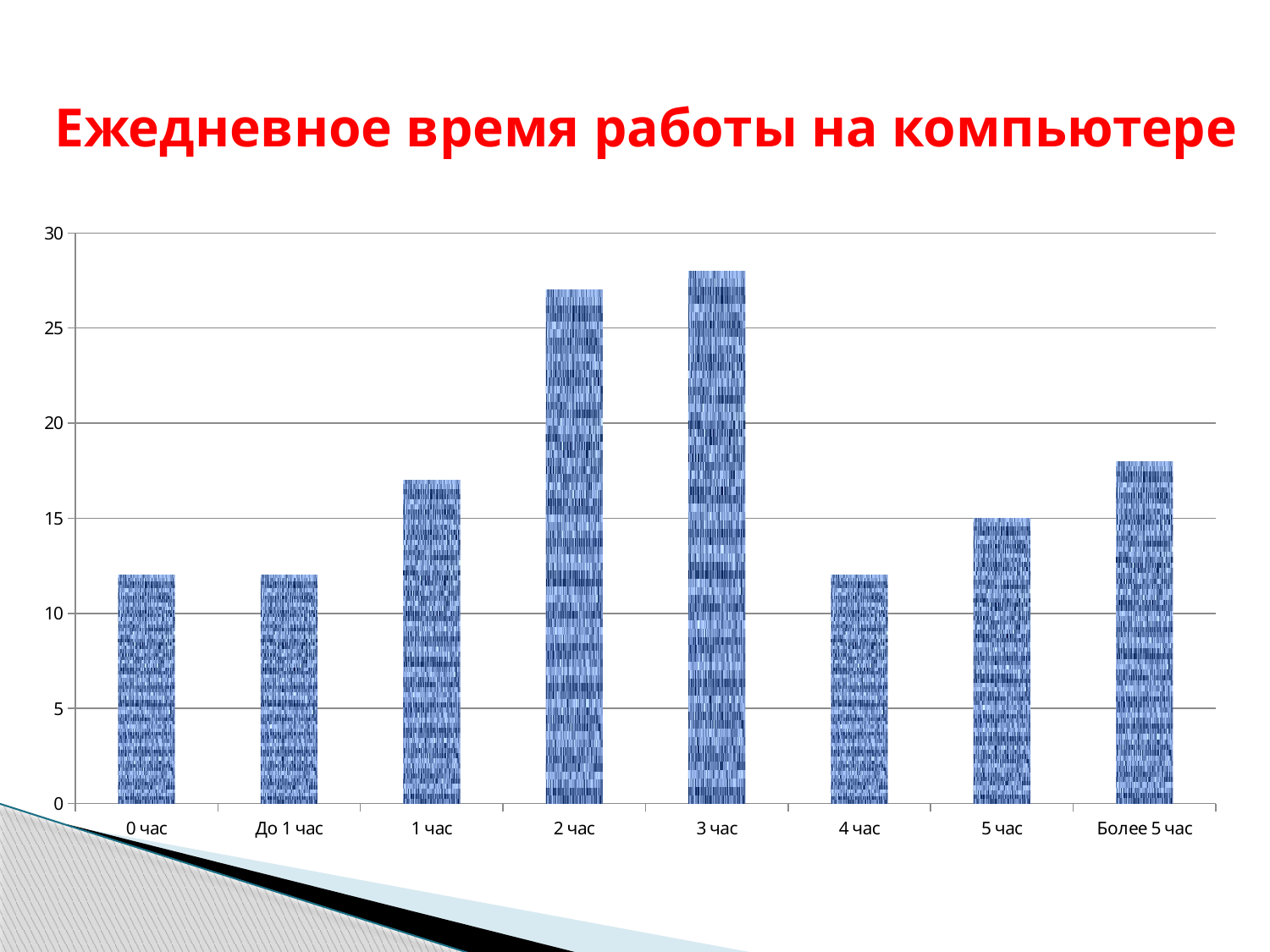
Is the value for "2 час" greater or less than 25? greater What is the title of the slide with the chart? Ежедневное время работы на компьютере What is the value for "5 час"? 15 Which is larger, the value for "5 час" or the value for "Более 5 час"? Более 5 час Is the value for "4 час" greater or less than 15? less What kind of chart is shown on the slide? bar chart Is the value for "3 час" greater or less than 25? greater Which is larger, the value for "2 час" or the value for "4 час"? 2 час How many categories are shown on the x axis of the chart? 8